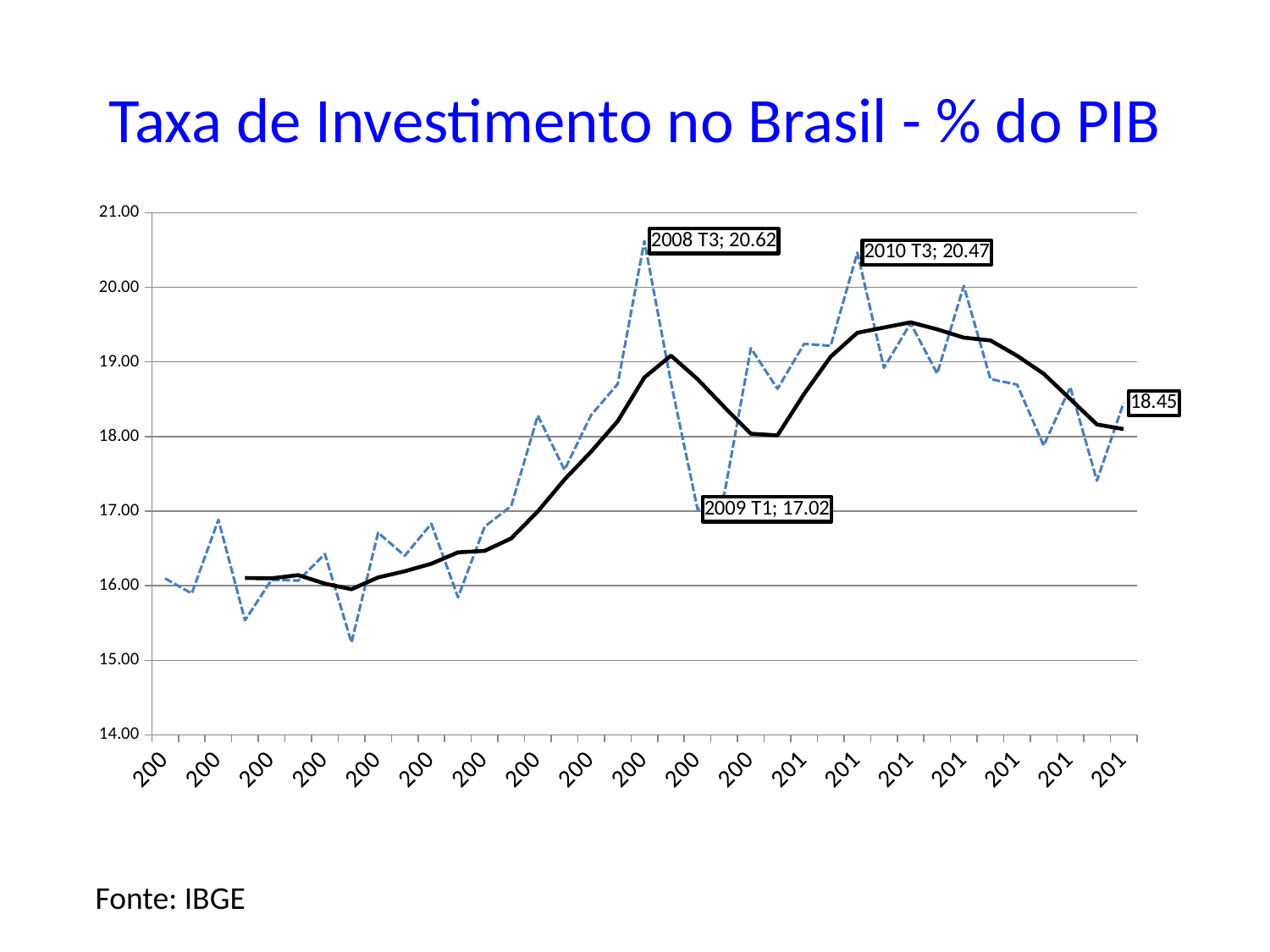
What is the value labelled at 2009 T1? 17.02 Which is larger, the value labelled at 2008 T3 or the value labelled at 2010 T3? 2008 T3 Which of the labelled points has the lowest value? 2009 T1 Is the lowest point of the dashed line greater or less than 16.00? less Between the labelled points 2008 T3 and 2009 T1, does the dashed line rise or fall? fall What is the value labelled at 2008 T3? 20.62 What value is labelled at the last point of the dashed line, on the far right of the chart? 18.45 What is the value labelled at 2010 T3? 20.47 What kind of chart is shown on the slide? line chart Which of the labelled points has the highest value? 2008 T3 What is the difference between the values labelled at 2008 T3 and 2009 T1? 3.60 What is the title of the chart? Taxa de Investimento no Brasil - % do PIB